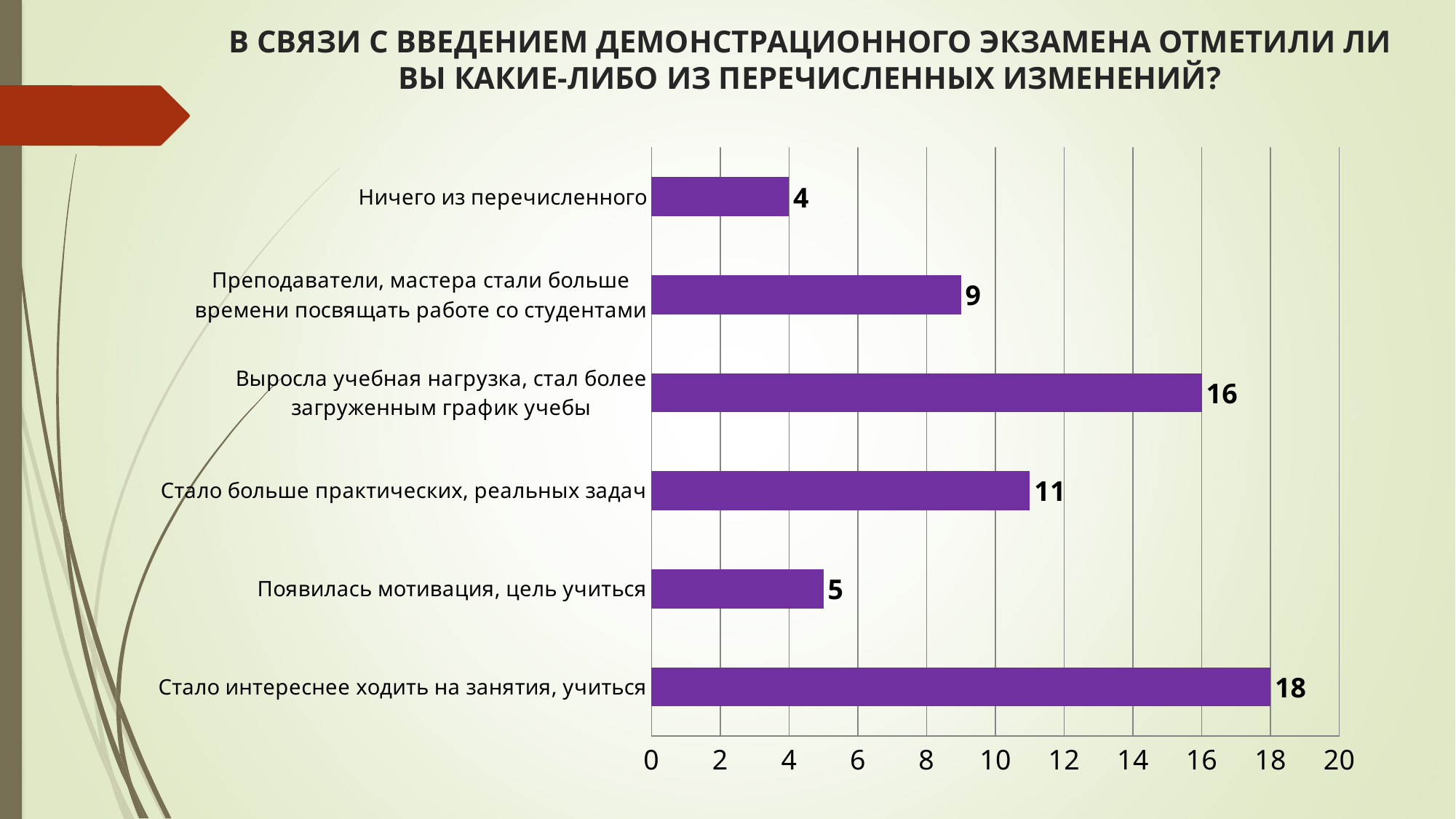
Which category has the lowest value? Ничего из перечисленного Which category has the highest value? Стало интереснее ходить на занятия, учиться What is the value for "Стало интереснее ходить на занятия, учиться"? 18 What colour are the bars in the chart? purple What is the value for "Стало больше практических, реальных задач"? 11 How many categories are shown in the chart? 6 What kind of chart is shown on the slide? bar chart Which is larger: the value for "Появилась мотивация, цель учиться" or the value for "Стало больше практических, реальных задач"? Стало больше практических, реальных задач What is the value for "Преподаватели, мастера стали больше времени посвящать работе со студентами"? 9 What is the difference between the values for "Стало интереснее ходить на занятия, учиться" and "Выросла учебная нагрузка, стал более загруженным график учебы"? 2 Is the value for "Выросла учебная нагрузка, стал более загруженным график учебы" greater or less than 10? greater What is the value for "Ничего из перечисленного"? 4